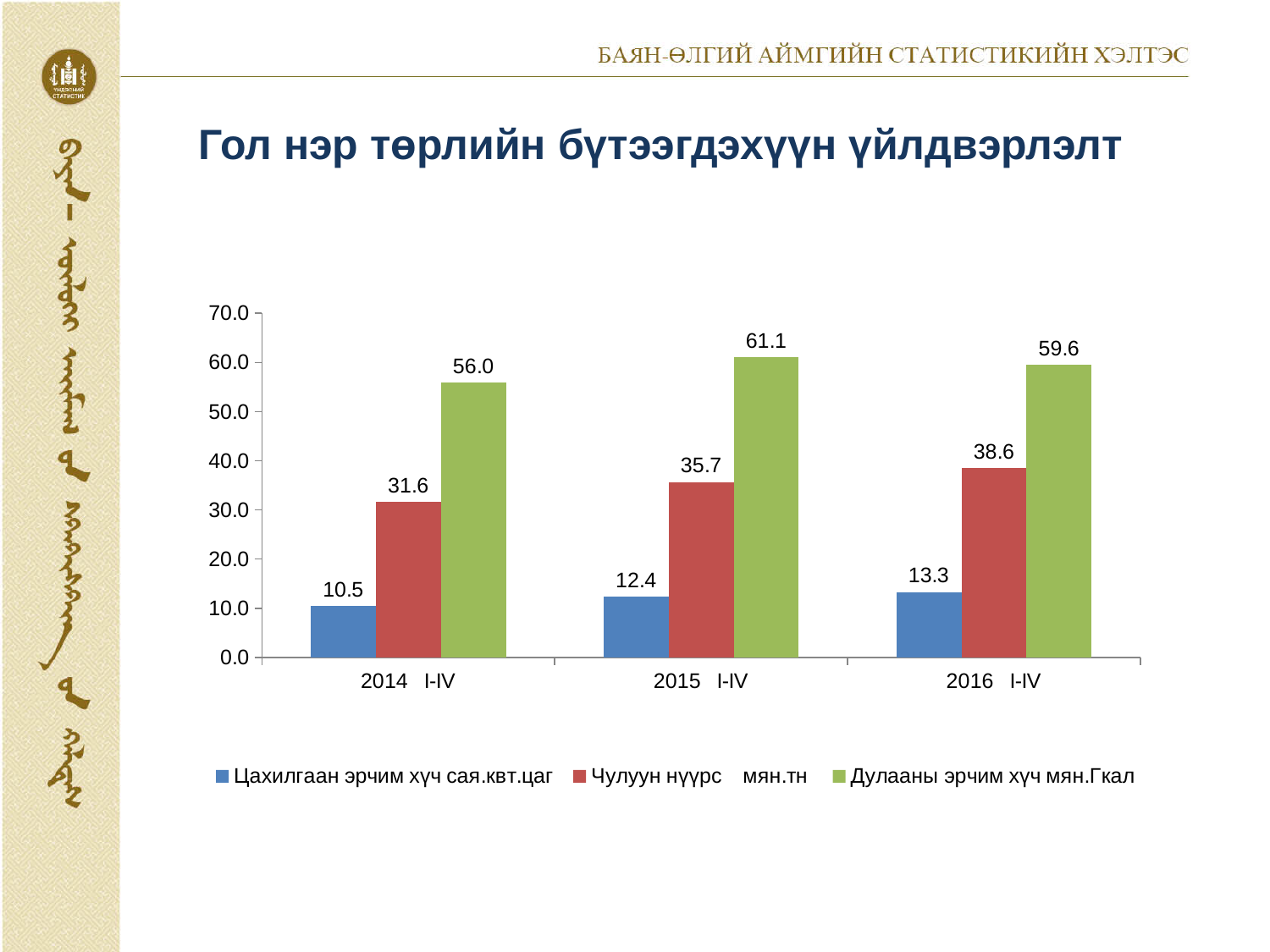
Which is larger: Дулааны эрчим хүч мян.Гкал in 2014 I-IV or in 2016 I-IV? 2016 I-IV In which period is Цахилгаан эрчим хүч сая.квт.цаг lowest? 2014 I-IV What is the value for Чулуун нүүрс мян.тн in 2015 I-IV? 35.7 What is the value for Цахилгаан эрчим хүч сая.квт.цаг in 2014 I-IV? 10.5 How many series does the legend list? 3 How many periods are shown on the x axis? 3 What kind of chart is shown on the slide? bar chart What is the difference between Чулуун нүүрс мян.тн in 2016 I-IV and 2014 I-IV? 7.0 What is the value for Дулааны эрчим хүч мян.Гкал in 2016 I-IV? 59.6 Is the value for Чулуун нүүрс мян.тн in 2016 I-IV greater or less than 40.0? less Does Чулуун нүүрс мян.тн rise or fall from 2014 I-IV to 2016 I-IV? rise In which period is Дулааны эрчим хүч мян.Гкал highest? 2015 I-IV